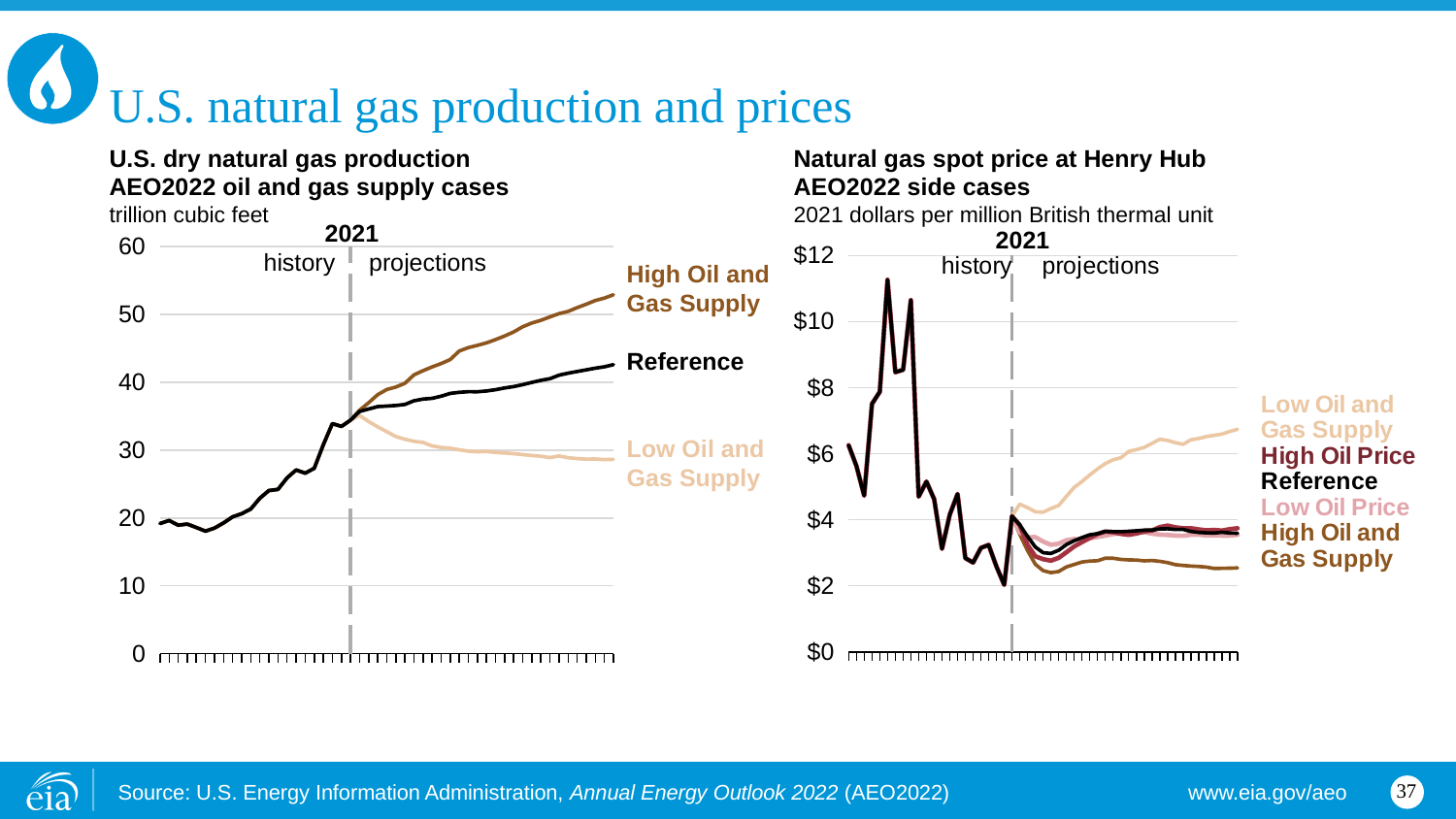
On the 'Natural gas spot price at Henry Hub' chart, which case has the highest price at the end of the projection period? Low Oil and Gas Supply What kind of chart is the 'Natural gas spot price at Henry Hub' chart on the right? line chart On the 'U.S. dry natural gas production' chart, does the Low Oil and Gas Supply case rise or fall over the projection period? fall On the 'U.S. dry natural gas production' chart, is the Low Oil and Gas Supply value at the end of the projections greater or less than 30? less On the 'Natural gas spot price at Henry Hub' chart, is the High Oil and Gas Supply price at the end of the projections greater or less than $4? less How many cases (series) are labelled on the 'Natural gas spot price at Henry Hub' chart on the right? 5 On the 'U.S. dry natural gas production' chart, is the High Oil and Gas Supply value at the end of the projections greater or less than 50? greater What unit is used on the y axis of the 'Natural gas spot price at Henry Hub' chart? 2021 dollars per million British thermal unit What kind of chart is the 'U.S. dry natural gas production' chart on the left? line chart On the 'U.S. dry natural gas production' chart, which case has the highest production at the end of the projection period? High Oil and Gas Supply How many cases (series) are labelled on the 'U.S. dry natural gas production' chart on the left? 3 On the 'U.S. dry natural gas production' chart, which case has the lowest production at the end of the projection period? Low Oil and Gas Supply